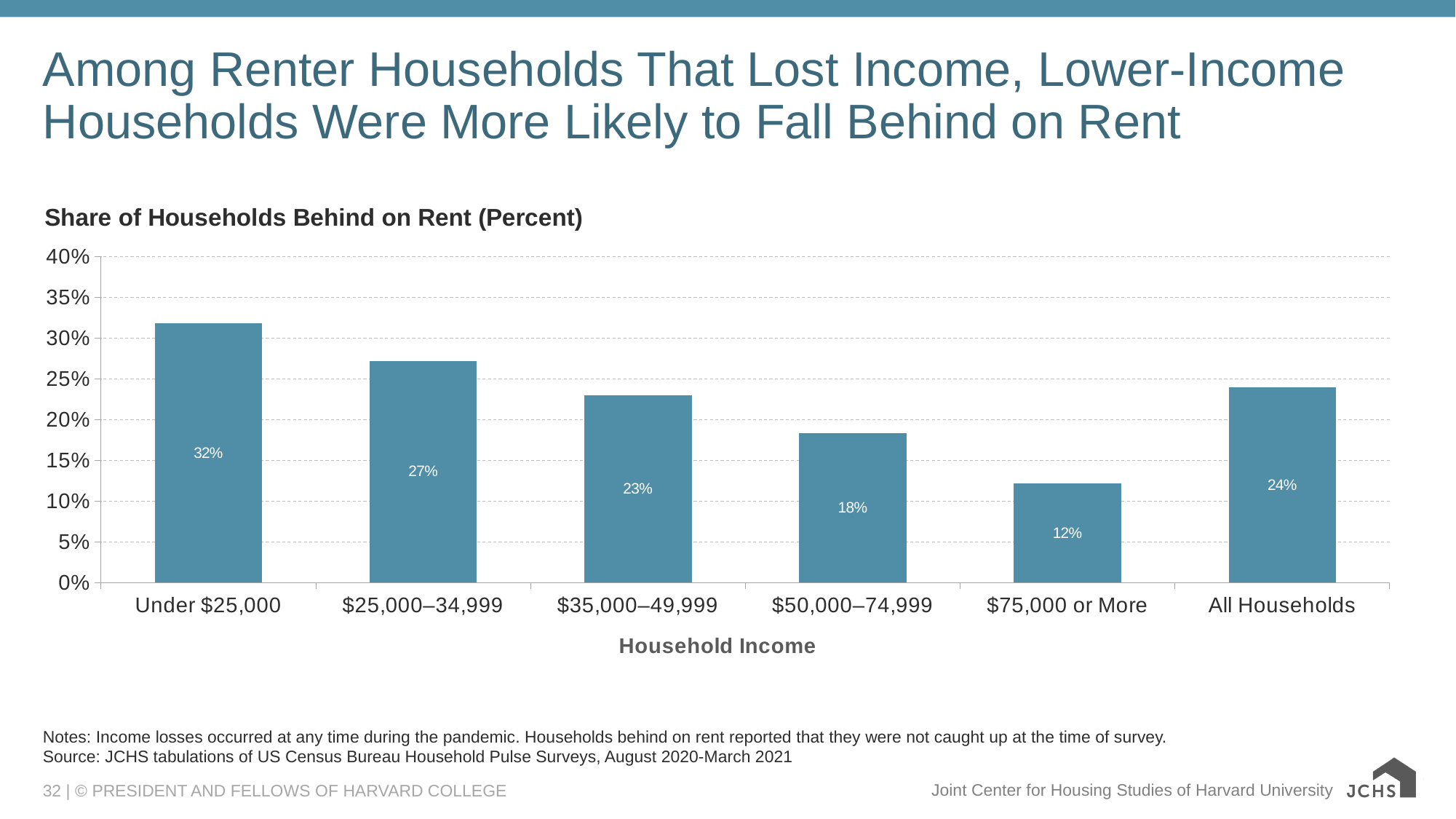
What is the label of the x axis? Household Income How many income categories are shown on the x axis? 6 What is the share of households behind on rent for the Under $25,000 income group? 32% Is the value for $35,000–49,999 greater or less than 20%? greater What is the share of households behind on rent for All Households? 24% What is the share of households behind on rent for the $50,000–74,999 income group? 18% Do the values rise or fall as household income increases from Under $25,000 to $75,000 or More? Fall What is the difference in share behind on rent between the Under $25,000 group and the $75,000 or More group? 20 percentage points Which income category has the lowest share of households behind on rent? $75,000 or More Which has a larger share of households behind on rent: $25,000–34,999 or $35,000–49,999? $25,000–34,999 What kind of chart is shown on the slide? Bar chart Which income category has the highest share of households behind on rent? Under $25,000